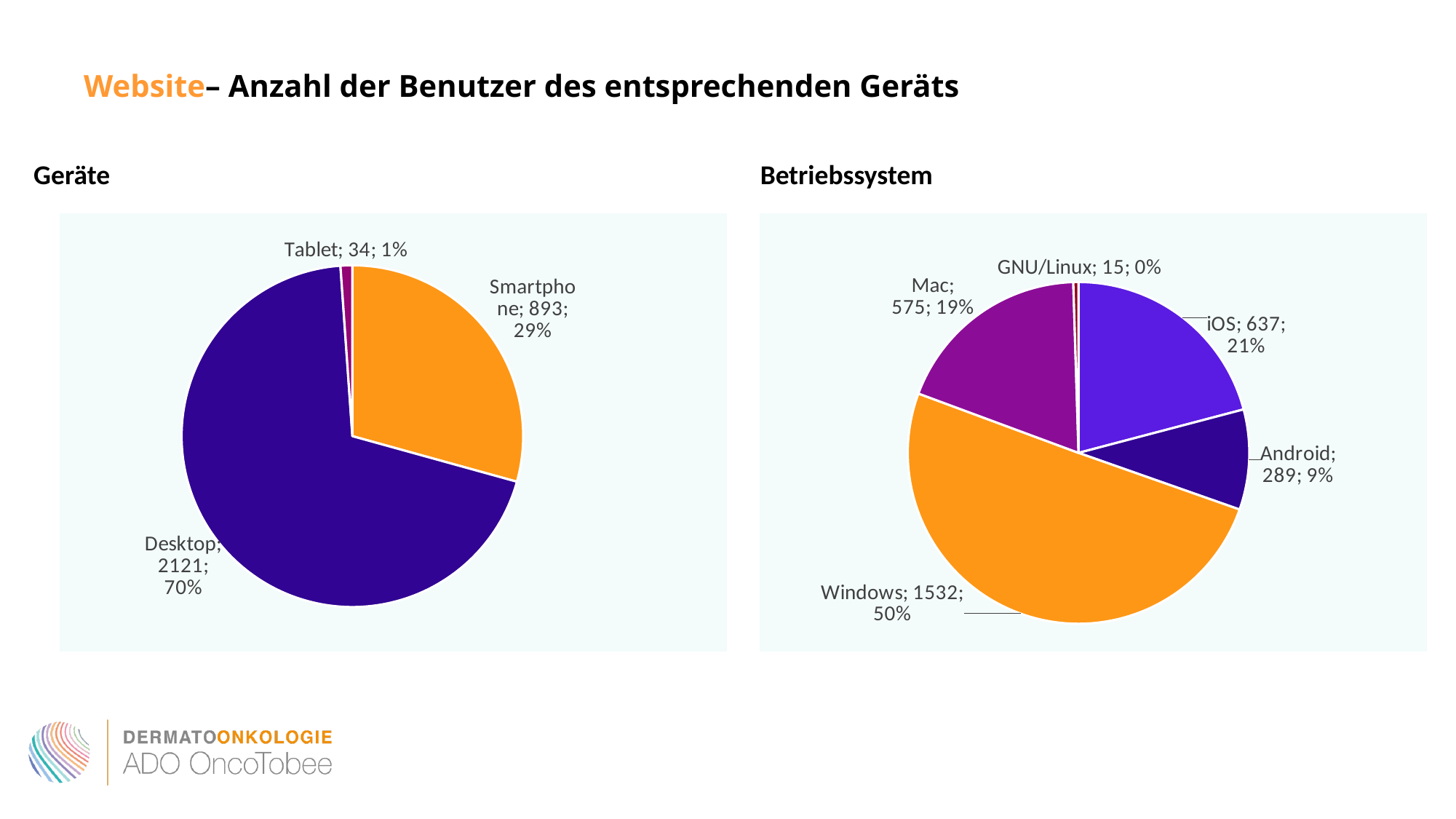
In the Betriebssystem chart, how many users are shown for Windows? 1532 In the Geräte chart, how many users are shown for Desktop? 2121 In the Geräte chart, what share of the pie does Smartphone have? 29% In the Betriebssystem chart, which category has the highest value? Windows In the Geräte chart, which category has the smallest value? Tablet What kind of chart is the Geräte chart? Pie chart In the Geräte chart, what is the difference between the Desktop and Smartphone values? 1228 In the Betriebssystem chart, how many categories are shown? 5 In the Betriebssystem chart, which is larger, iOS or Android? iOS In the Geräte chart, how many categories are shown? 3 In the Betriebssystem chart, what share of the pie does Mac have? 19% In the Betriebssystem chart, what is the difference between the iOS and Mac values? 62